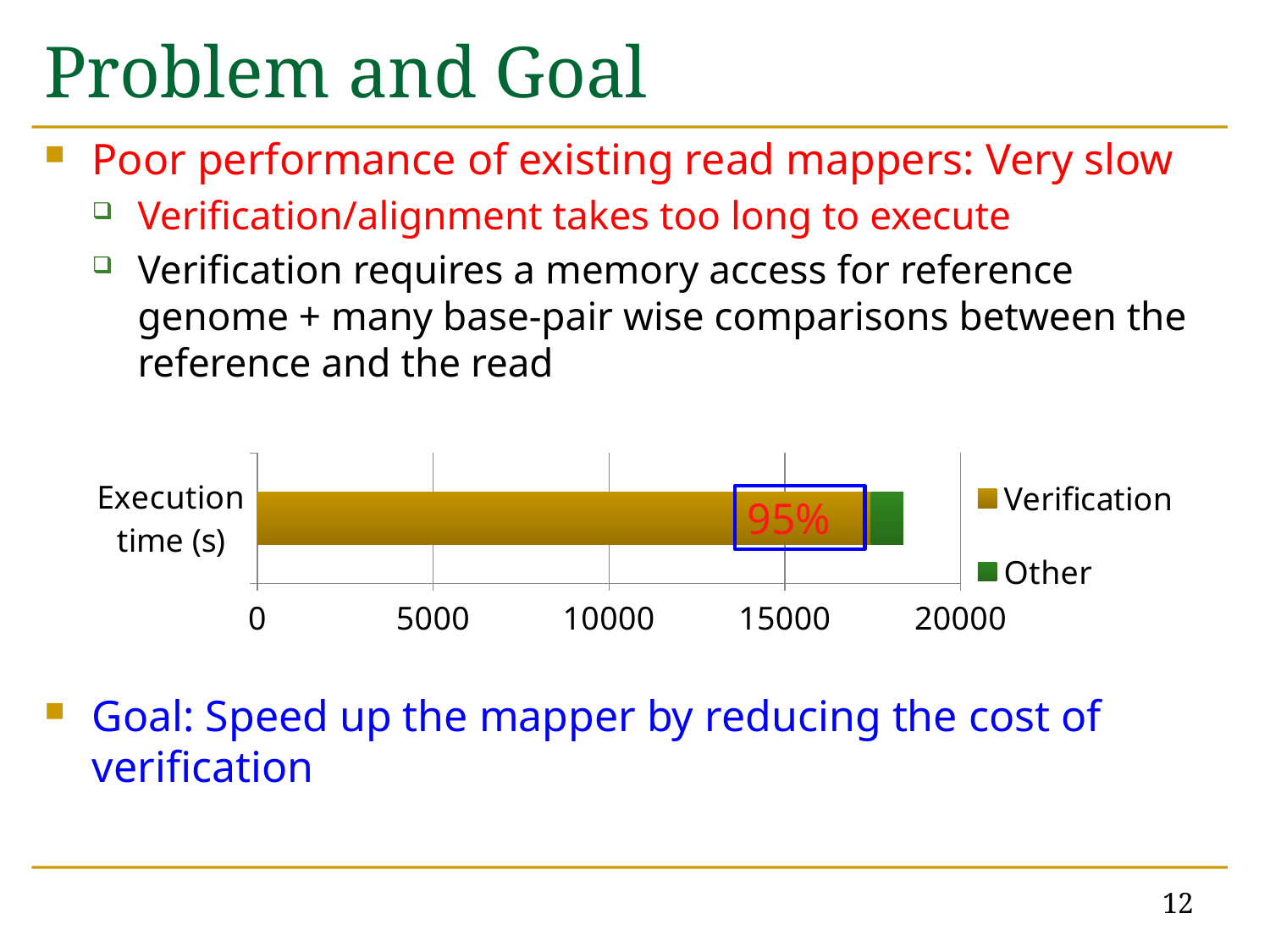
How many categories are plotted on the chart's vertical axis? 1 How many series does the chart legend list? 2 Is the Verification segment of the execution time bar greater or less than 15000? greater What is the label of the single category plotted in the chart? Execution time (s) Which series has the smallest share of the execution time bar? Other Is the total length of the execution time bar greater or less than 20000? less What kind of chart is shown on the slide? bar chart What is the highest tick value shown on the chart's horizontal axis? 20000 Is the Other segment of the execution time bar greater or less than 5000? less What percentage label is printed on the Verification segment of the bar? 95% What are the two series named in the chart legend? Verification and Other Which series takes up the larger portion of the execution time bar, Verification or Other? Verification